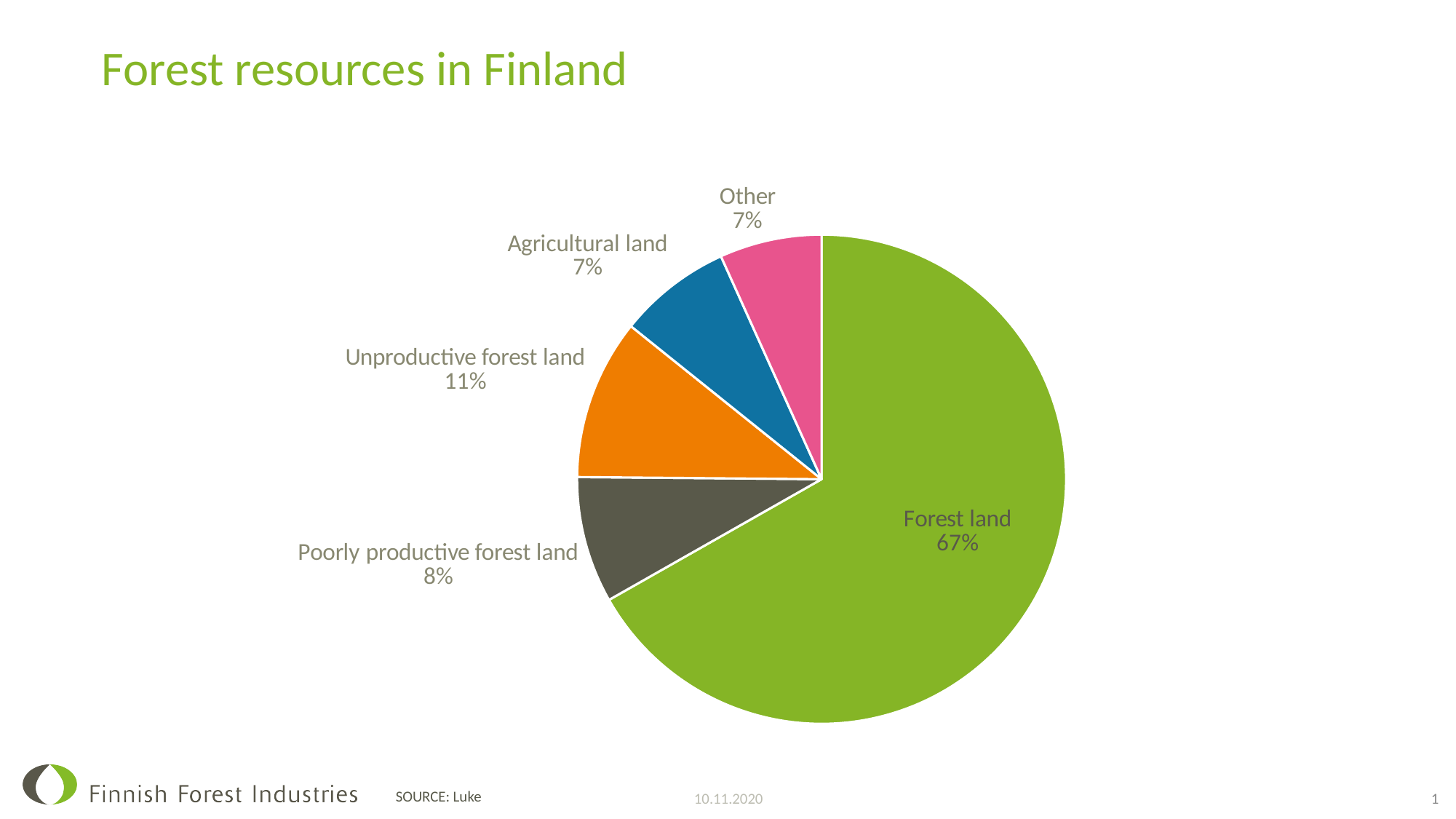
What share of the pie is Unproductive forest land? 11% What is the difference in percentage points between Forest land and Unproductive forest land? 56 Which is larger, Unproductive forest land or Poorly productive forest land? Unproductive forest land What share of the pie is Poorly productive forest land? 8% What is the difference in percentage points between Unproductive forest land and Other? 4 What is the title of the chart? Forest resources in Finland What share of the pie is Forest land? 67% Which category has the largest slice of the pie? Forest land What kind of chart is shown on the slide? pie chart How many slices does the pie chart have? 5 What colour is the Forest land slice? green